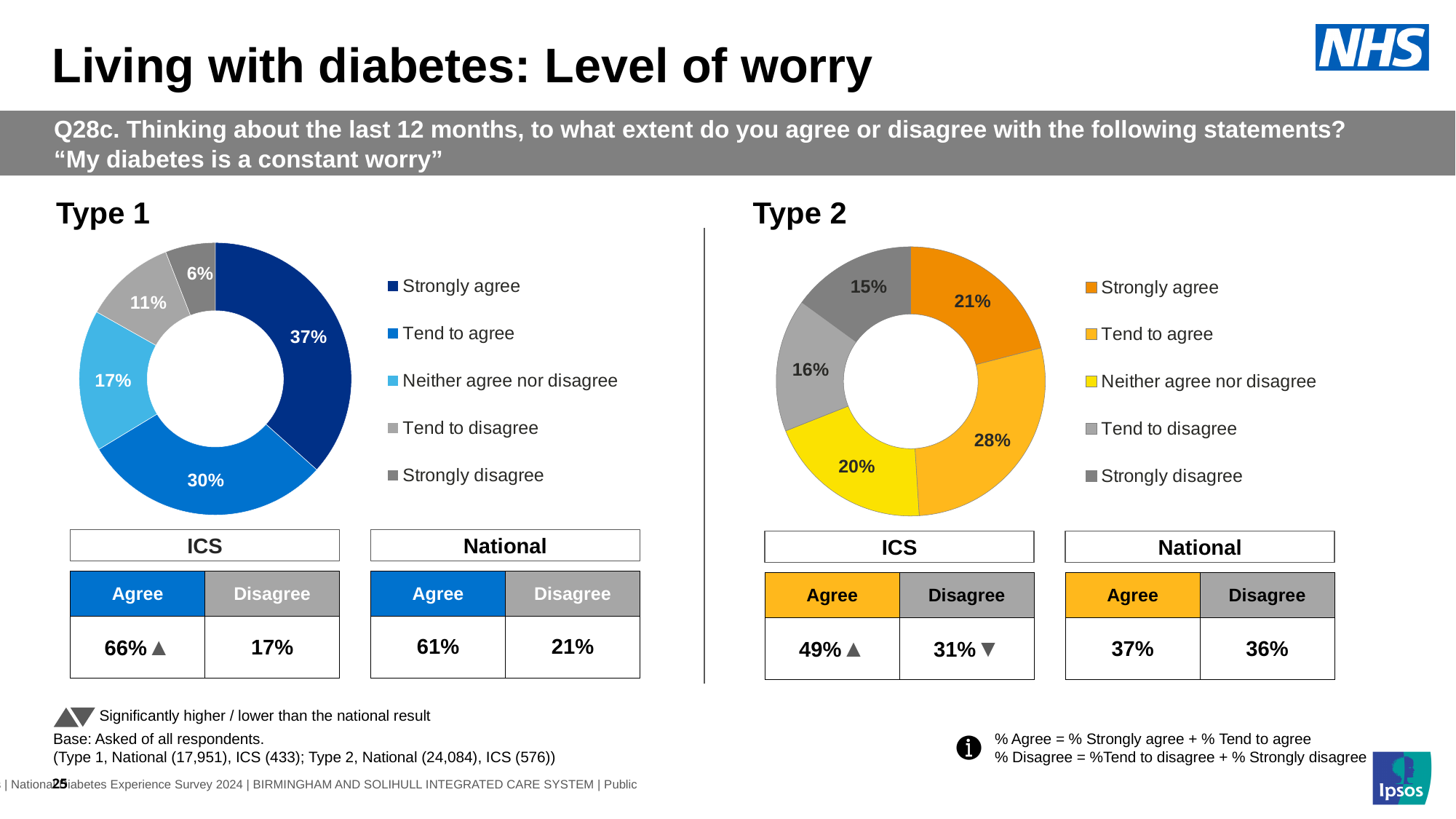
In the Type 1 chart, what percentage of respondents said they strongly agree? 37% In the Type 2 chart, which is larger: the 'Tend to disagree' share or the 'Strongly disagree' share? Tend to disagree In the Type 2 chart, what is the difference between the 'Tend to agree' and 'Strongly agree' shares? 7 percentage points In the Type 1 chart, what colour represents 'Neither agree nor disagree'? Light blue What kind of chart is used for the Type 2 data? Doughnut (pie) chart In the Type 1 chart, what is the difference between the 'Tend to agree' and 'Neither agree nor disagree' shares? 13 percentage points In the Type 1 chart, which response category has the largest share? Strongly agree In the Type 2 chart, which response category has the smallest share? Strongly disagree In the Type 1 chart, what is the combined share of 'Tend to disagree' and 'Strongly disagree'? 17% In the Type 2 chart, what percentage of respondents said they neither agree nor disagree? 20% How many categories does the Type 1 chart's legend list? 5 In the Type 2 chart, what percentage of respondents said they tend to agree? 28%